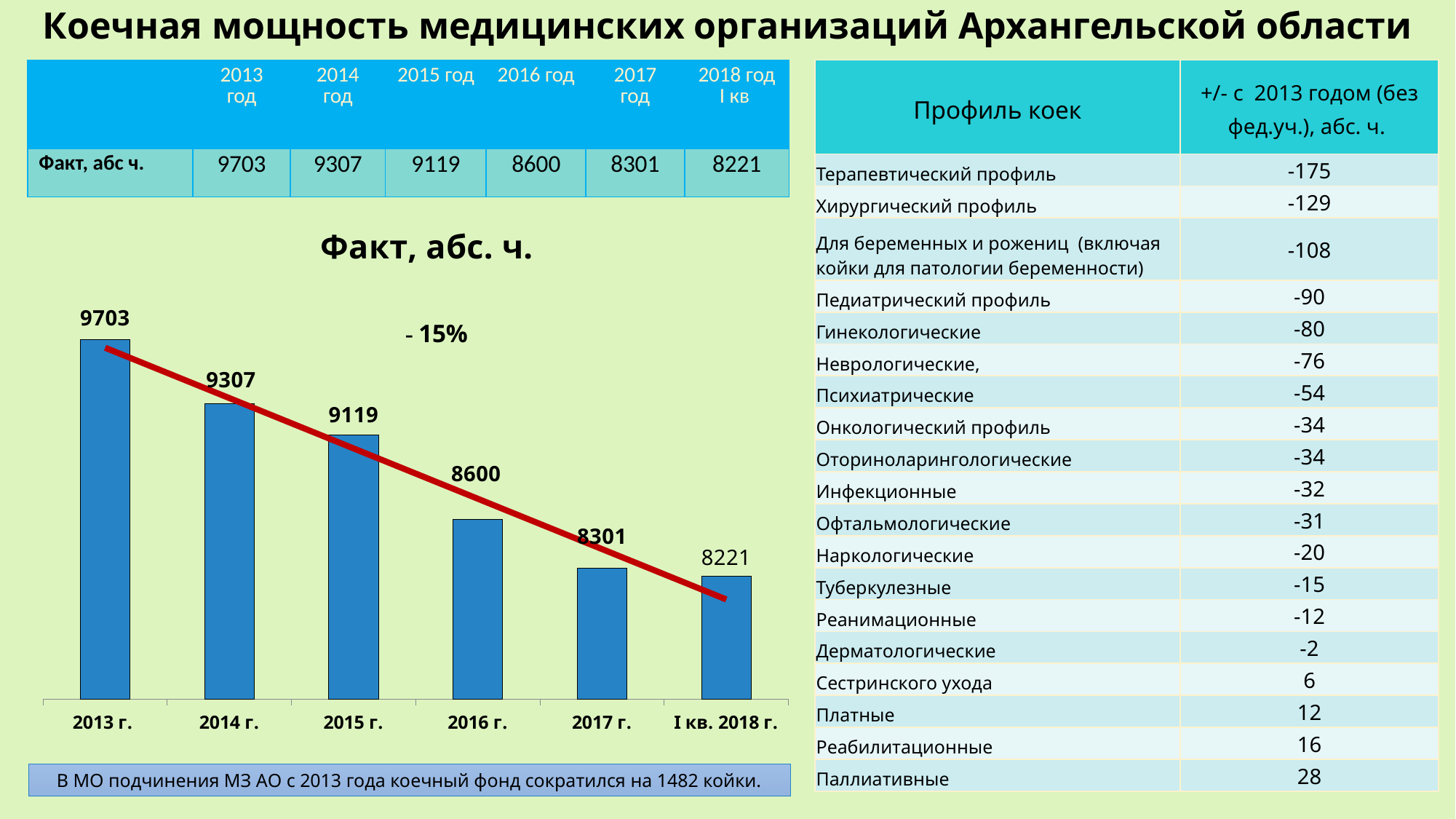
What kind of chart is "Факт, абс. ч."? bar chart What is the difference between the values for 2015 г. and 2016 г. in the chart "Факт, абс. ч."? 519 Do the values in the chart "Факт, абс. ч." rise or fall from 2013 г. to I кв. 2018 г.? fall What is the difference between the values for 2013 г. and I кв. 2018 г. in the chart "Факт, абс. ч."? 1482 How many bars are plotted in the chart "Факт, абс. ч."? 6 Which category has the lowest value in the chart "Факт, абс. ч."? I кв. 2018 г. What is the value for 2016 г. in the chart "Факт, абс. ч."? 8600 Which is larger in the chart "Факт, абс. ч.": the value for 2014 г. or the value for 2017 г.? 2014 г. What is the value for I кв. 2018 г. in the chart "Факт, абс. ч."? 8221 What percentage change is annotated next to the red trend line in the chart "Факт, абс. ч."? - 15% Which category has the highest value in the chart "Факт, абс. ч."? 2013 г. What is the value for 2013 г. in the chart "Факт, абс. ч."? 9703